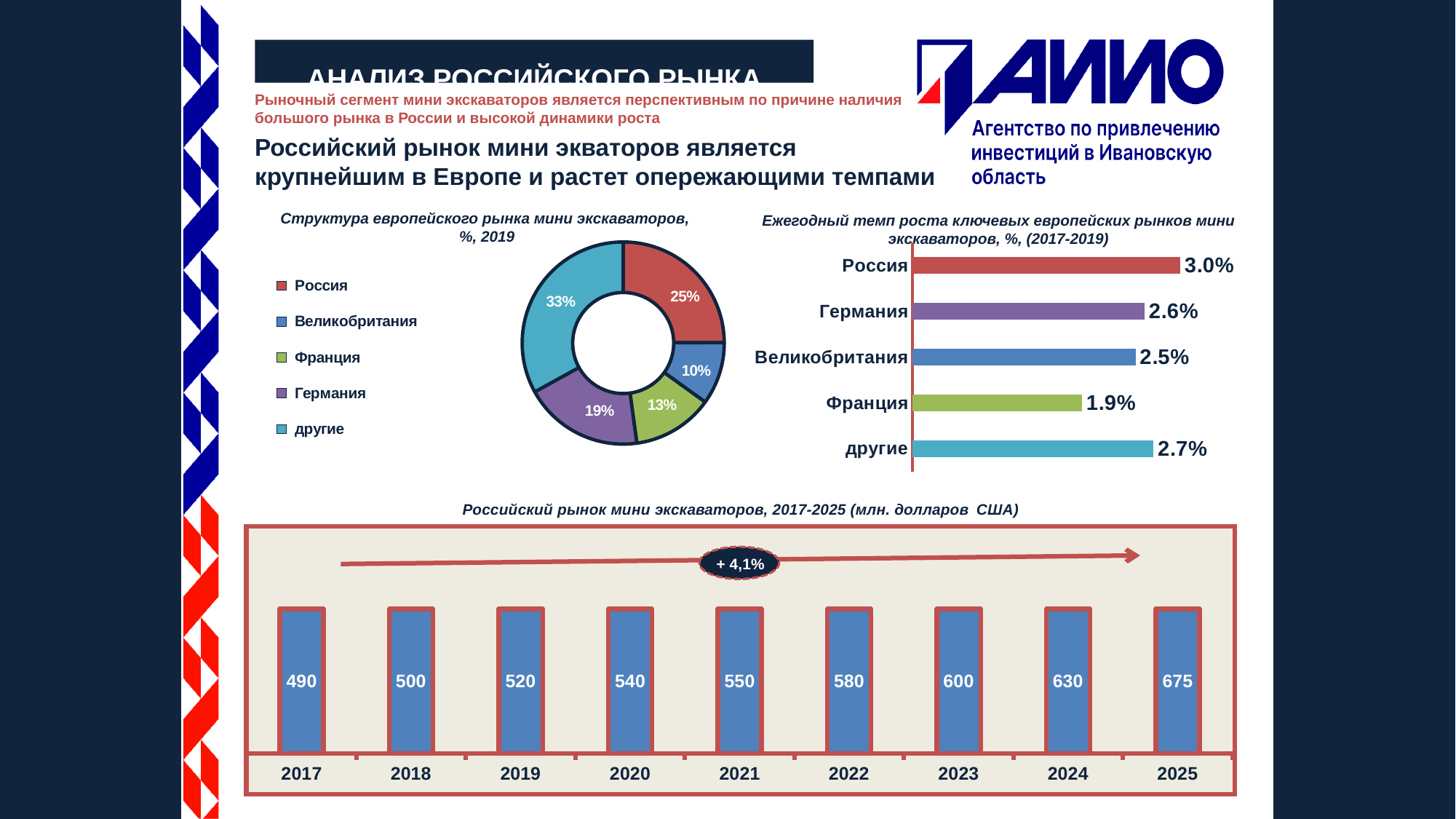
In the chart 'Российский рынок мини экскаваторов, 2017-2025 (млн. долларов США)', do the values rise or fall from 2017 to 2025? Rise In the chart 'Российский рынок мини экскаваторов, 2017-2025 (млн. долларов США)', what is the difference between the values for 2025 and 2017? 185 In the chart 'Структура европейского рынка мини экскаваторов, %, 2019', which segment has the smallest share? Великобритания In the chart 'Ежегодный темп роста ключевых европейских рынков мини экскаваторов, %, (2017-2019)', which is larger: the value for Великобритания or for другие? другие In the chart 'Структура европейского рынка мини экскаваторов, %, 2019', which segment has the largest share? другие What type of chart is 'Структура европейского рынка мини экскаваторов, %, 2019'? Donut (pie) chart In the chart 'Ежегодный темп роста ключевых европейских рынков мини экскаваторов, %, (2017-2019)', which market has the lowest growth rate? Франция In the chart 'Структура европейского рынка мини экскаваторов, %, 2019', how many segments does the legend list? 5 In the chart 'Структура европейского рынка мини экскаваторов, %, 2019', what share does Россия hold? 25% In the chart 'Российский рынок мини экскаваторов, 2017-2025 (млн. долларов США)', what is the value for 2022? 580 In the chart 'Ежегодный темп роста ключевых европейских рынков мини экскаваторов, %, (2017-2019)', what is the value for Германия? 2.6% In the chart 'Ежегодный темп роста ключевых европейских рынков мини экскаваторов, %, (2017-2019)', what is the difference between the values for Россия and Франция? 1.1%